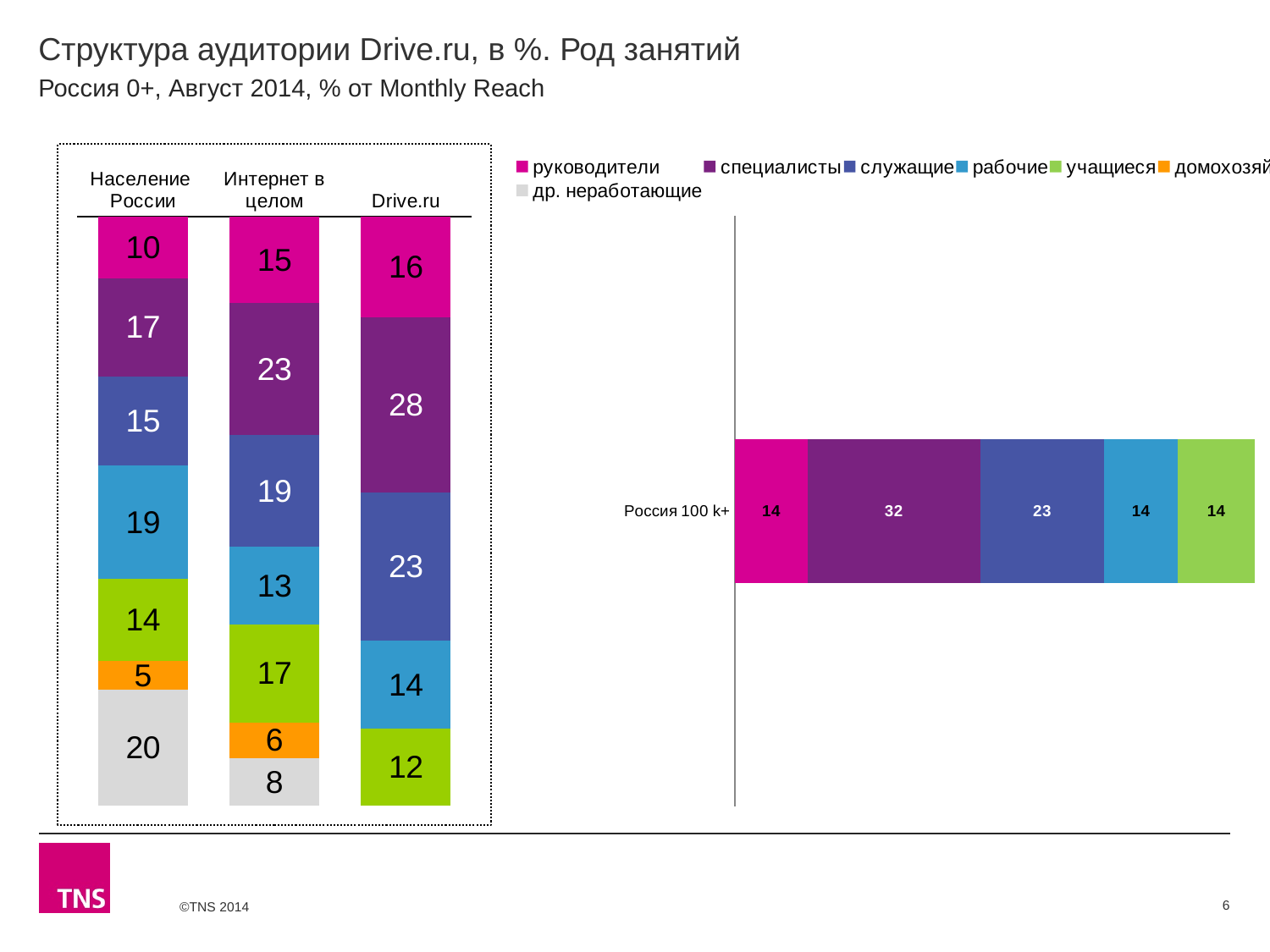
In the left chart, what is the value for рабочие in the Интернет в целом bar? 13 In the right chart (Россия 100 k+), what is the value for специалисты? 32 In the left chart, which is larger: служащие for Drive.ru or служащие for Интернет в целом? Drive.ru How many series does the legend list? 7 In the right chart (Россия 100 k+), which segment is the largest? специалисты In the left chart, what is the value for специалисты in the Drive.ru bar? 28 In the left chart, what is the difference between the специалисты values for Drive.ru and Население России? 11 In the left chart, which segment is the smallest in the Население России bar? домохозяйки (5) In the left chart, what is the value for др. неработающие in the Население России bar? 20 In the right chart (Россия 100 k+), what is the total of all segments? 97 How many bars (categories) does the left chart show? 3 What kind of chart is the right chart (Россия 100 k+)? Stacked bar chart